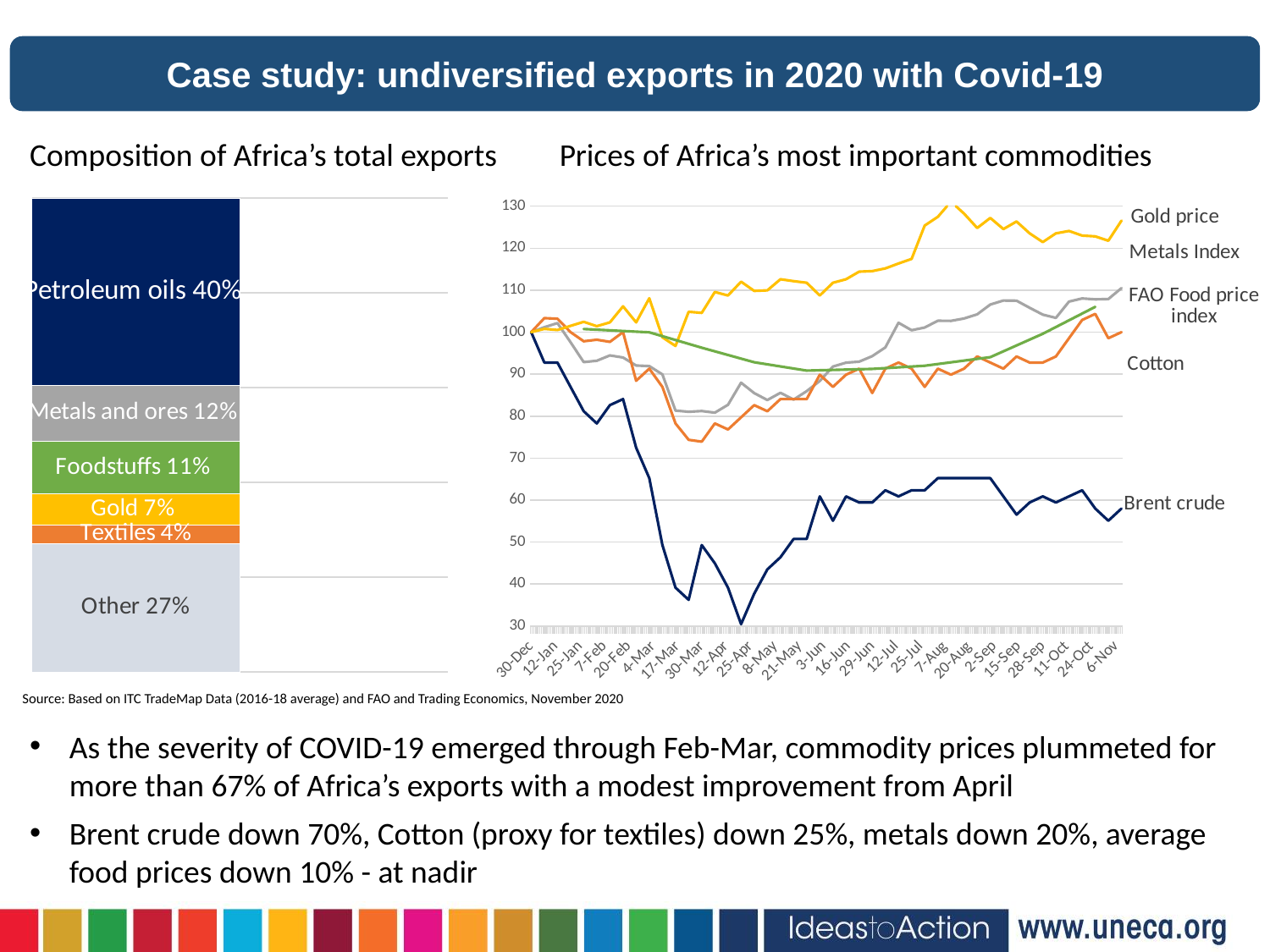
How many categories are shown in the 'Composition of Africa's total exports' chart? 6 In the 'Prices of Africa's most important commodities' chart, is the value for Brent crude at 25-Apr greater or less than 40? less In the 'Prices of Africa's most important commodities' chart, which series has the highest value at 6-Nov? Gold price In the 'Composition of Africa's total exports' chart, which category has the smallest share? Textiles In the 'Composition of Africa's total exports' chart, which has the larger share, Gold or Textiles? Gold In the 'Prices of Africa's most important commodities' chart, is the value for Gold price at 6-Nov greater or less than 120? greater In the 'Composition of Africa's total exports' chart, what share do Metals and ores account for? 12% How many series are shown in the 'Prices of Africa's most important commodities' chart? 5 In the 'Composition of Africa's total exports' chart, which named category has the largest share? Petroleum oils What kind of chart is 'Prices of Africa's most important commodities'? Line chart In the 'Composition of Africa's total exports' chart, how many percentage points larger is the Petroleum oils share than the Metals and ores share? 28% In the 'Composition of Africa's total exports' chart, what share do Petroleum oils account for? 40%